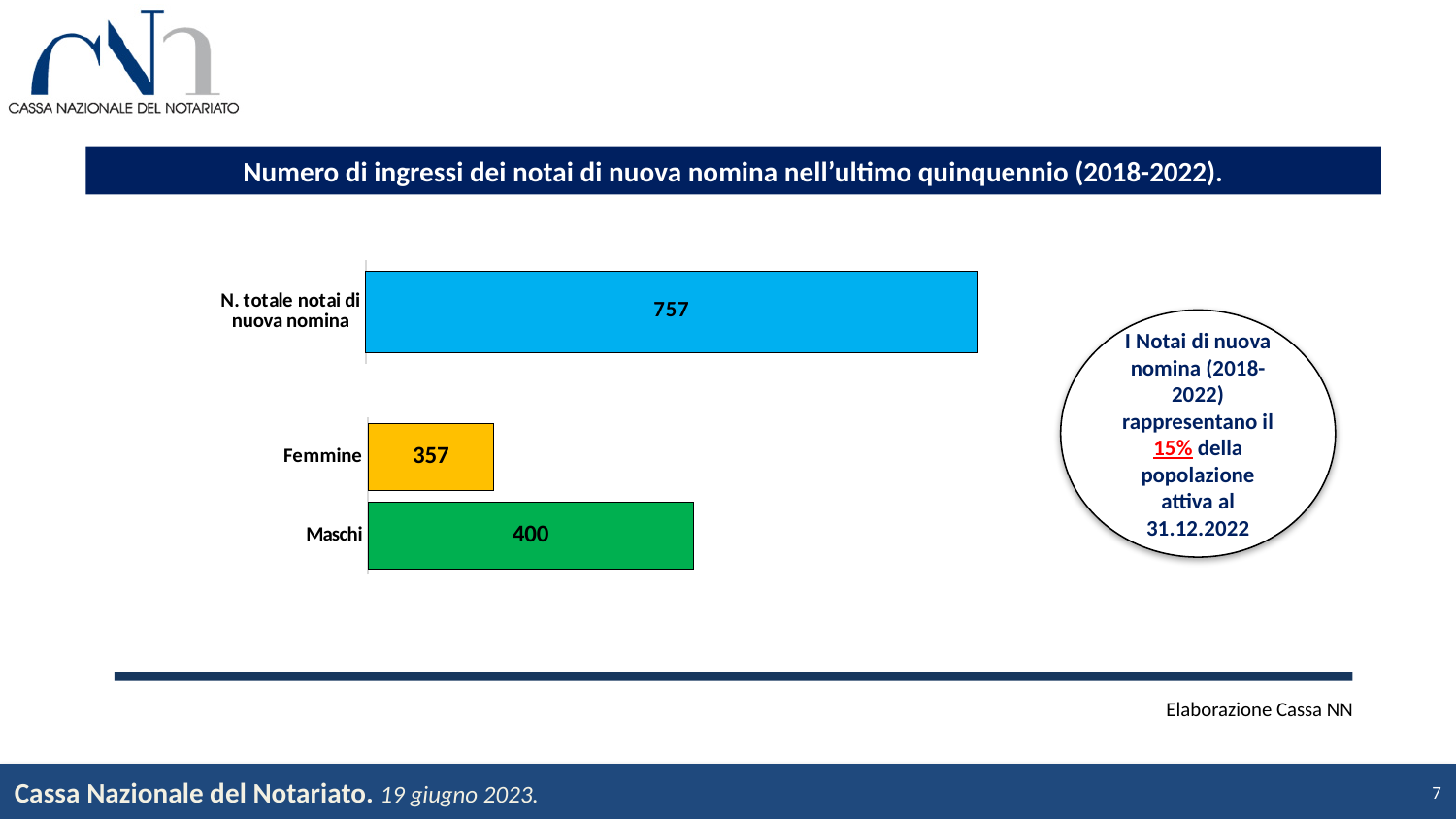
What is the difference between the values for Maschi and Femmine? 43 What is the value for Femmine? 357 What kind of chart is shown on the slide? Bar chart How many bars are shown in the chart? 3 What is the value for N. totale notai di nuova nomina? 757 What colour is the bar for Femmine? Yellow What is the value for Maschi? 400 Which category has the highest value? N. totale notai di nuova nomina Which category has the lowest value? Femmine What is the title of the chart? Numero di ingressi dei notai di nuova nomina nell'ultimo quinquennio (2018-2022). Which is larger, the value for Maschi or the value for Femmine? Maschi What is the sum of the values for Maschi and Femmine? 757